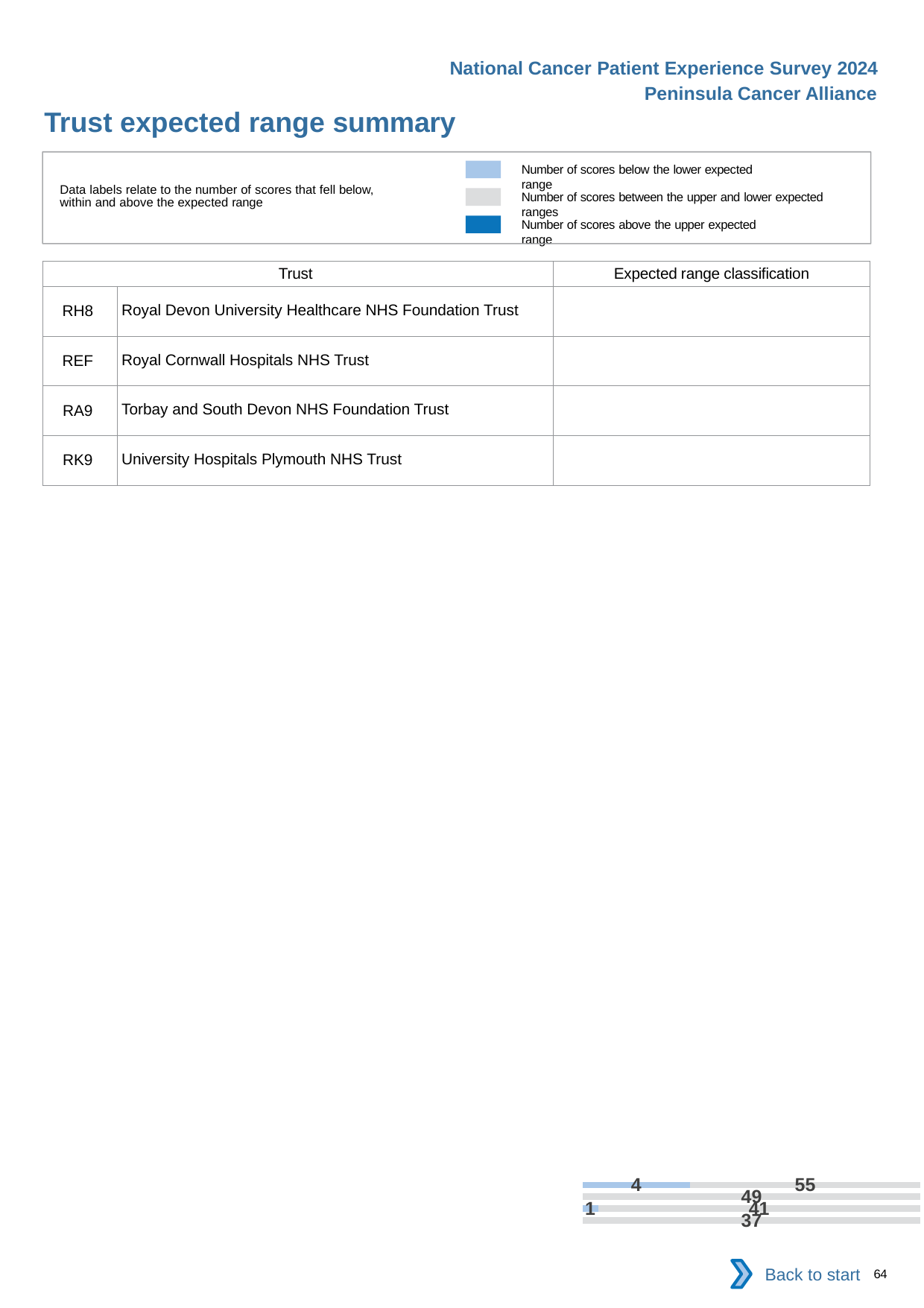
In the topmost bar at the bottom of the slide, which segment is larger, the light blue one or the grey one? grey What is the difference between the grey segment (55) and the light blue segment (4) in the topmost bar at the bottom of the slide? 51 According to the legend, what does the light blue colour represent? Number of scores below the lower expected range In the topmost bar at the bottom of the slide, what is the data label on the grey segment? 55 What kind of chart is shown at the bottom of the slide? bar chart How many entries does the legend in the box at the top of the slide list? 3 According to the legend, what does the dark blue colour represent? Number of scores above the upper expected range In the topmost bar at the bottom of the slide, what is the data label on the light blue segment? 4 What is the total of the two labelled segments in the topmost bar at the bottom of the slide? 59